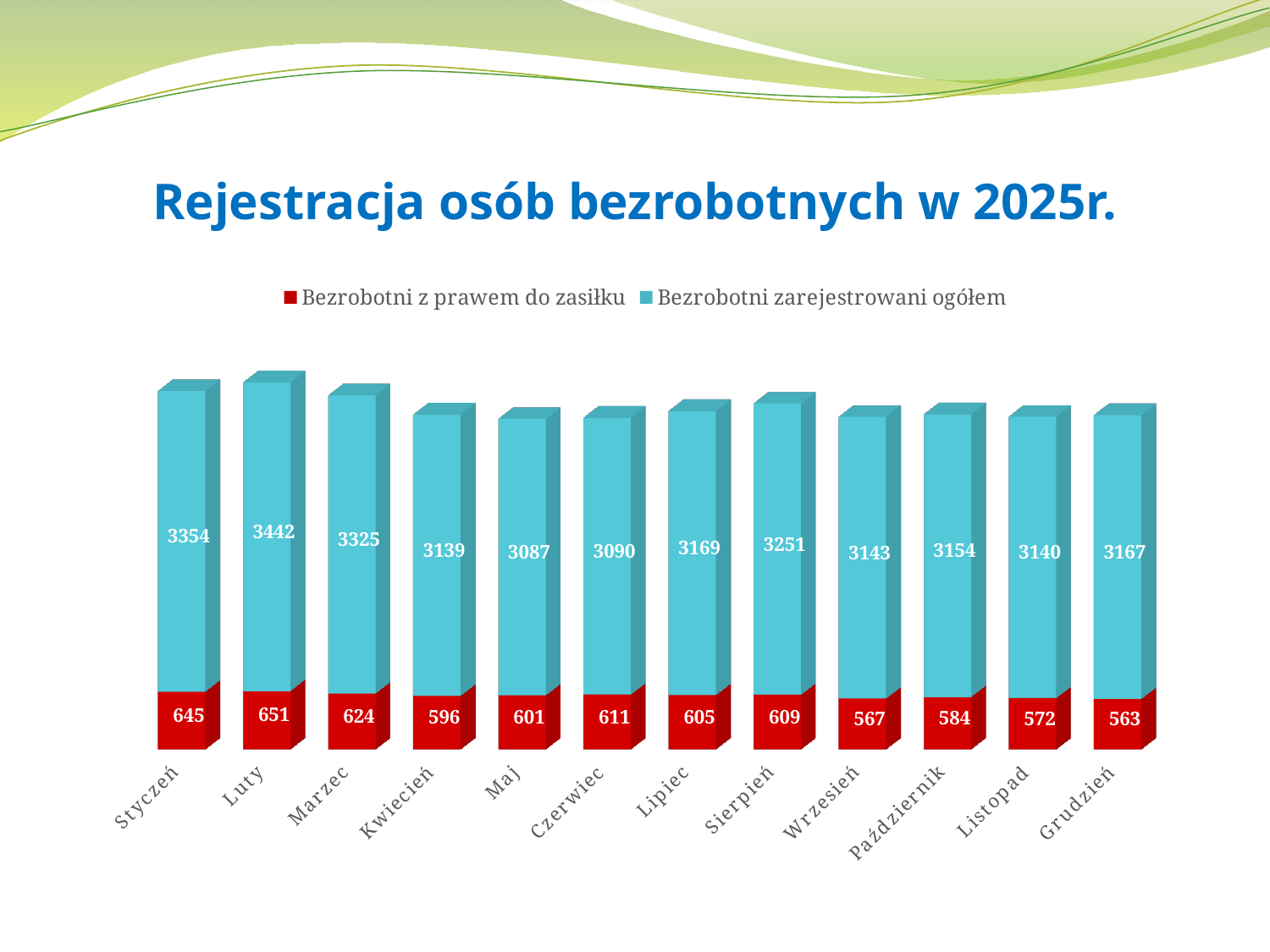
What is the value of "Bezrobotni zarejestrowani ogółem" for Luty? 3442 Which month has the larger value for "Bezrobotni zarejestrowani ogółem", Lipiec or Sierpień? Sierpień How many series does the legend list? 2 Which month has the lowest value for "Bezrobotni z prawem do zasiłku"? Grudzień Which month has the highest value for "Bezrobotni zarejestrowani ogółem"? Luty What is the value of "Bezrobotni z prawem do zasiłku" for Wrzesień? 567 What kind of chart is shown on the slide? Stacked bar chart How many months are shown on the x axis of the chart? 12 What is the total of the stacked bar for Styczeń? 3999 Which month has the lowest value for "Bezrobotni zarejestrowani ogółem"? Maj What is the title of the chart? Rejestracja osób bezrobotnych w 2025r. What is the difference between the "Bezrobotni zarejestrowani ogółem" values for Luty and Styczeń? 88